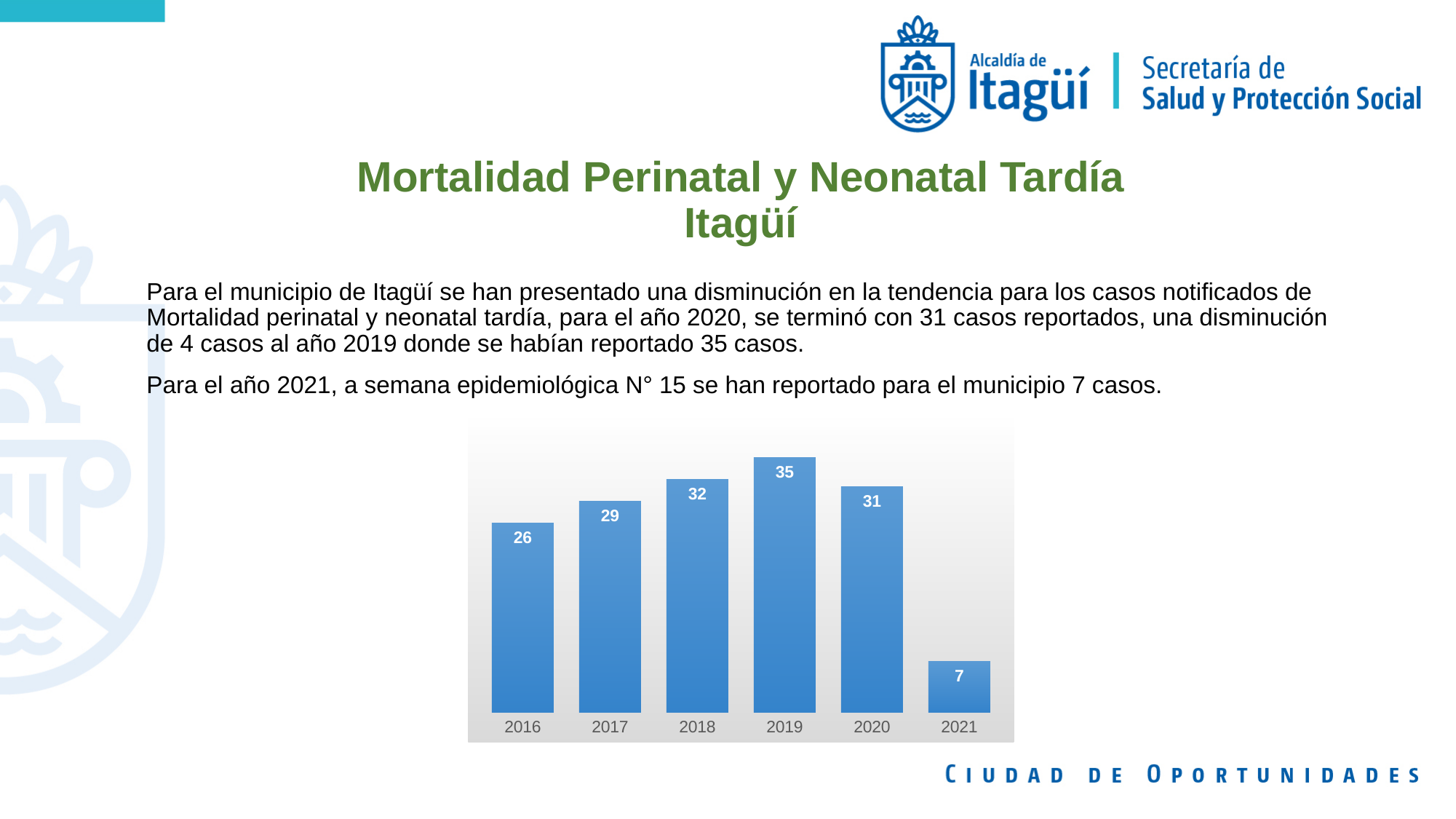
What is the value for 2016? 26 What is the value for 2021? 7 Which year has the lowest value? 2021 What is the difference between the values for 2019 and 2020? 4 How many years are shown on the x axis? 6 What is the difference between the values for 2018 and 2016? 6 What colour are the bars in the chart? blue Do the values rise or fall from 2016 to 2019? rise Which is larger, the value for 2017 or the value for 2020? 2020 What kind of chart is shown on the slide? bar chart Which year has the highest value? 2019 What is the value for 2019? 35